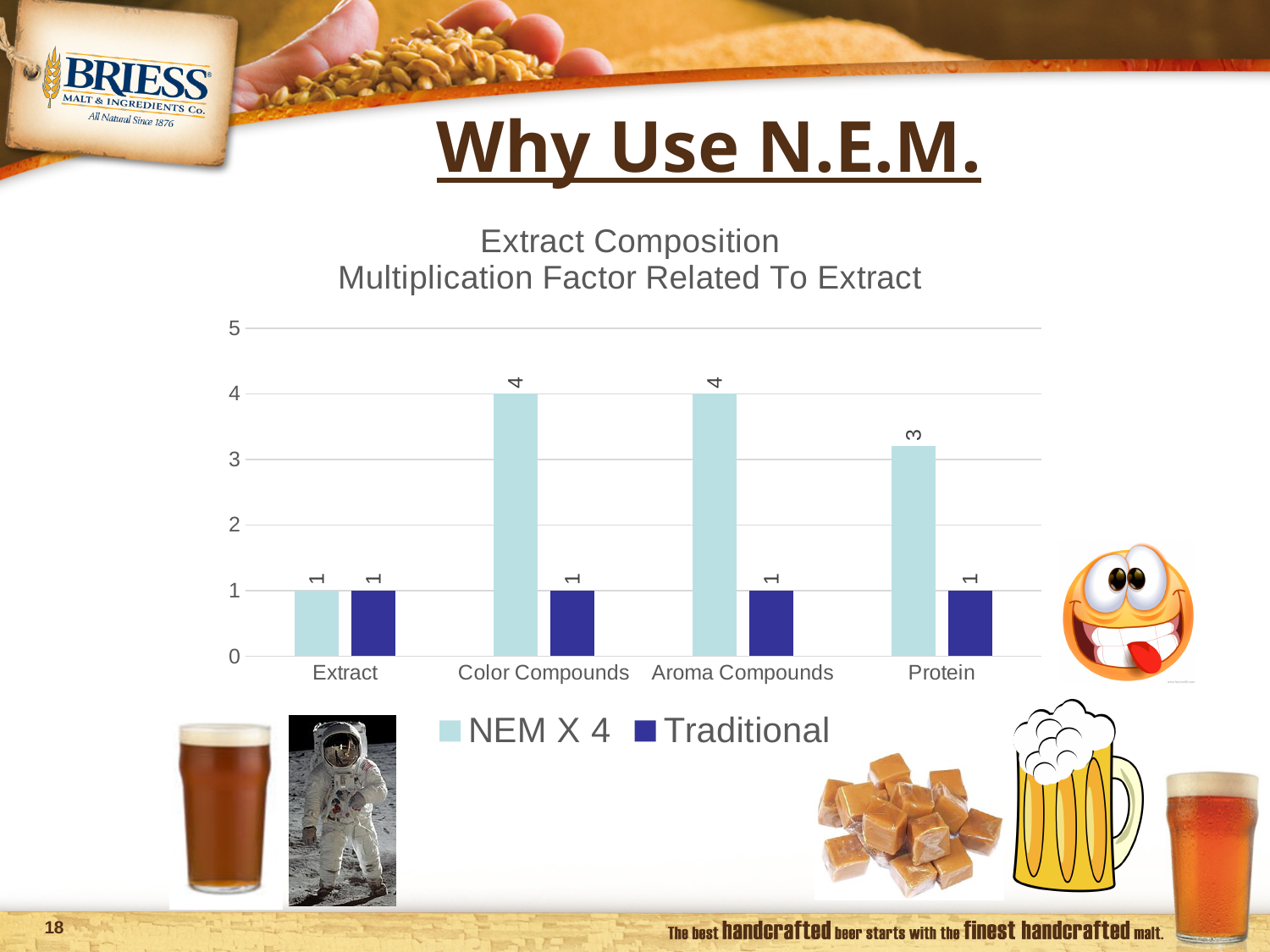
What is the NEM X 4 value for Extract? 1 What is the difference between the NEM X 4 and Traditional values for Aroma Compounds? 3 What kind of chart is shown on the slide? Bar chart What is the Traditional value for Aroma Compounds? 1 How many series does the legend list? 2 How many categories are shown on the x axis? 4 What is the NEM X 4 value for Protein? 3 Which is larger for Protein, the NEM X 4 value or the Traditional value? NEM X 4 What is the title of the chart? Extract Composition Multiplication Factor Related To Extract Which category has the lowest NEM X 4 value? Extract What is the difference between the NEM X 4 values for Color Compounds and Protein? 1 What is the NEM X 4 value for Color Compounds? 4